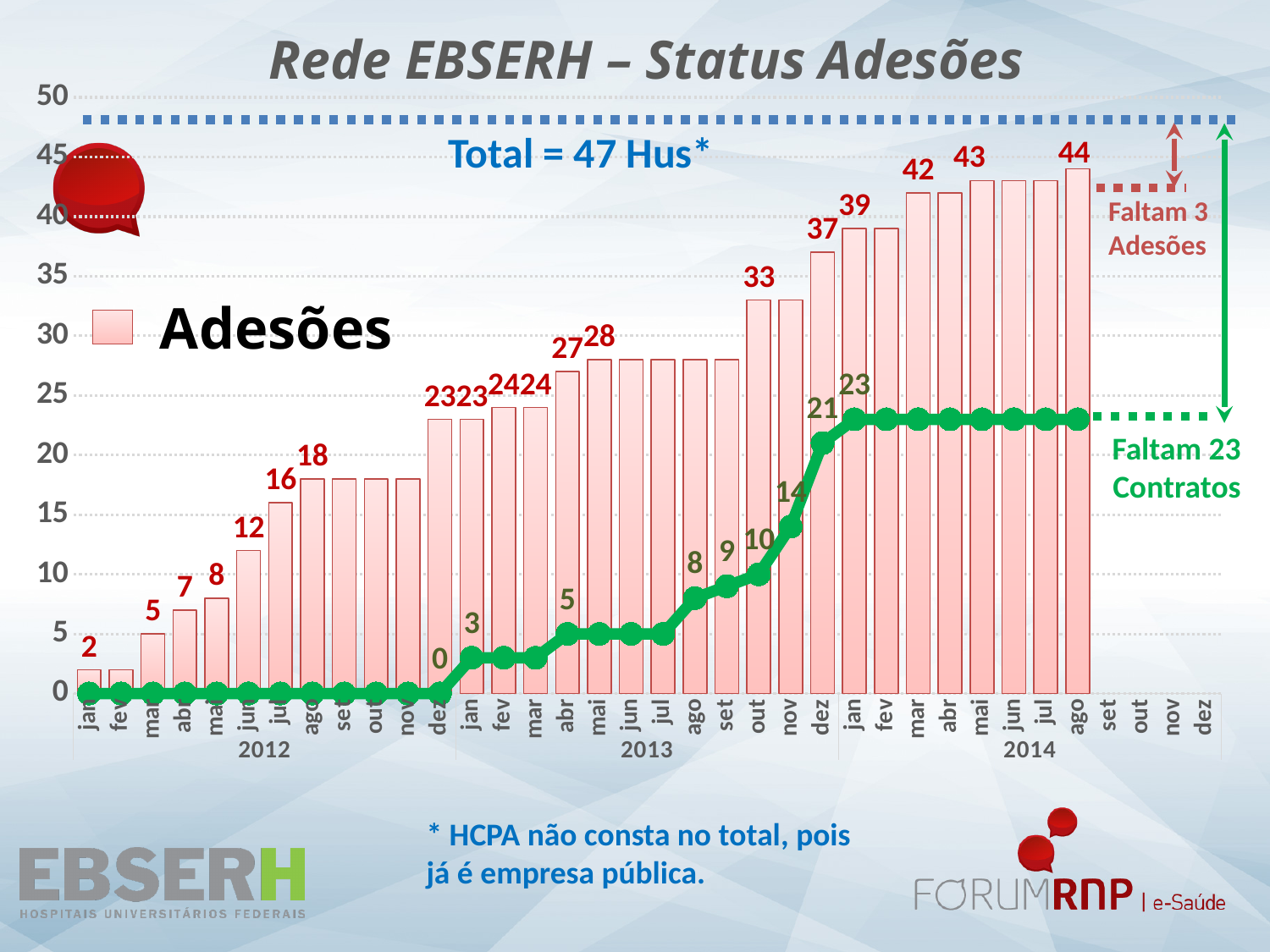
What value does the green line show for jan 2014? 23 What value does the green line show for nov 2013? 14 What is the difference between the Adesões values for jul 2012 and jun 2012? 4 Do the Adesões values rise or fall from jan 2012 to ago 2014? rise What total is stated above the chart? Total = 47 Hus What is the Adesões value for ago 2014? 44 What is the difference between the Adesões values for ago 2014 and dez 2013? 7 What kind of chart is shown on the slide? Bar chart with a line Which month has the highest Adesões bar? ago 2014 What is the Adesões value for dez 2013? 37 Is the Adesões value for set 2012 greater or less than 20? less Which is larger, the Adesões value for out 2013 or for abr 2013? out 2013